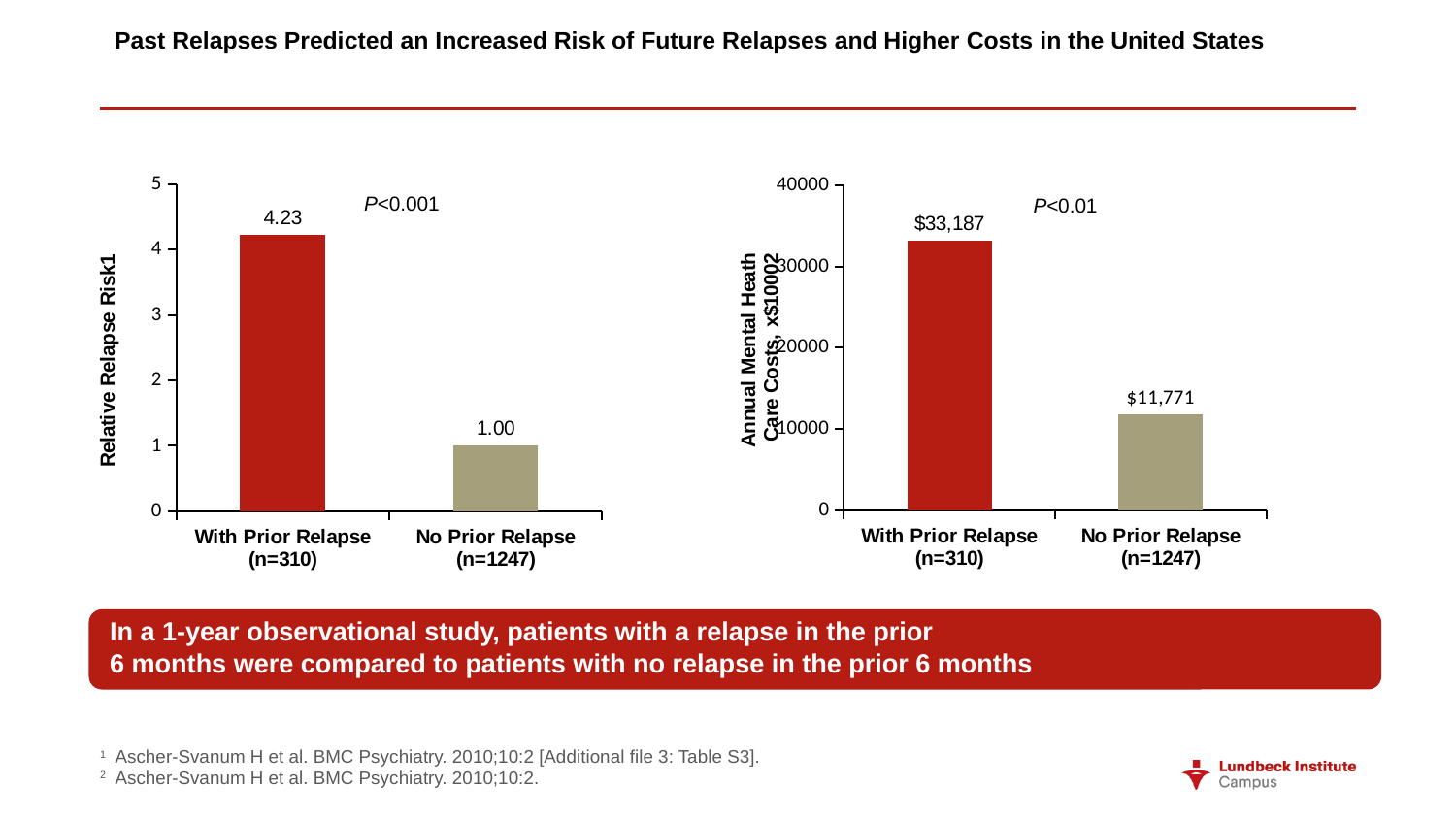
In the right chart (Annual Mental Health Care Costs), what is the value for No Prior Relapse (n=1247)? $11,771 In the right chart (Annual Mental Health Care Costs), is the value for With Prior Relapse greater or less than 30000? greater In the left chart (Relative Relapse Risk), what is the difference between the With Prior Relapse and No Prior Relapse values? 3.23 In the right chart (Annual Mental Health Care Costs), which category has the lowest value? No Prior Relapse (n=1247) What kind of chart is the right chart (Annual Mental Health Care Costs)? bar chart What P value is shown on the left chart (Relative Relapse Risk)? P<0.001 In the left chart (Relative Relapse Risk), what is the value for No Prior Relapse (n=1247)? 1.00 In the left chart (Relative Relapse Risk), which category has the highest value? With Prior Relapse (n=310) In the right chart (Annual Mental Health Care Costs), what is the difference between the With Prior Relapse and No Prior Relapse values? $21,416 In the right chart (Annual Mental Health Care Costs), what is the value for With Prior Relapse (n=310)? $33,187 How many categories are shown in the left chart (Relative Relapse Risk)? 2 In the left chart (Relative Relapse Risk), what is the value for With Prior Relapse (n=310)? 4.23